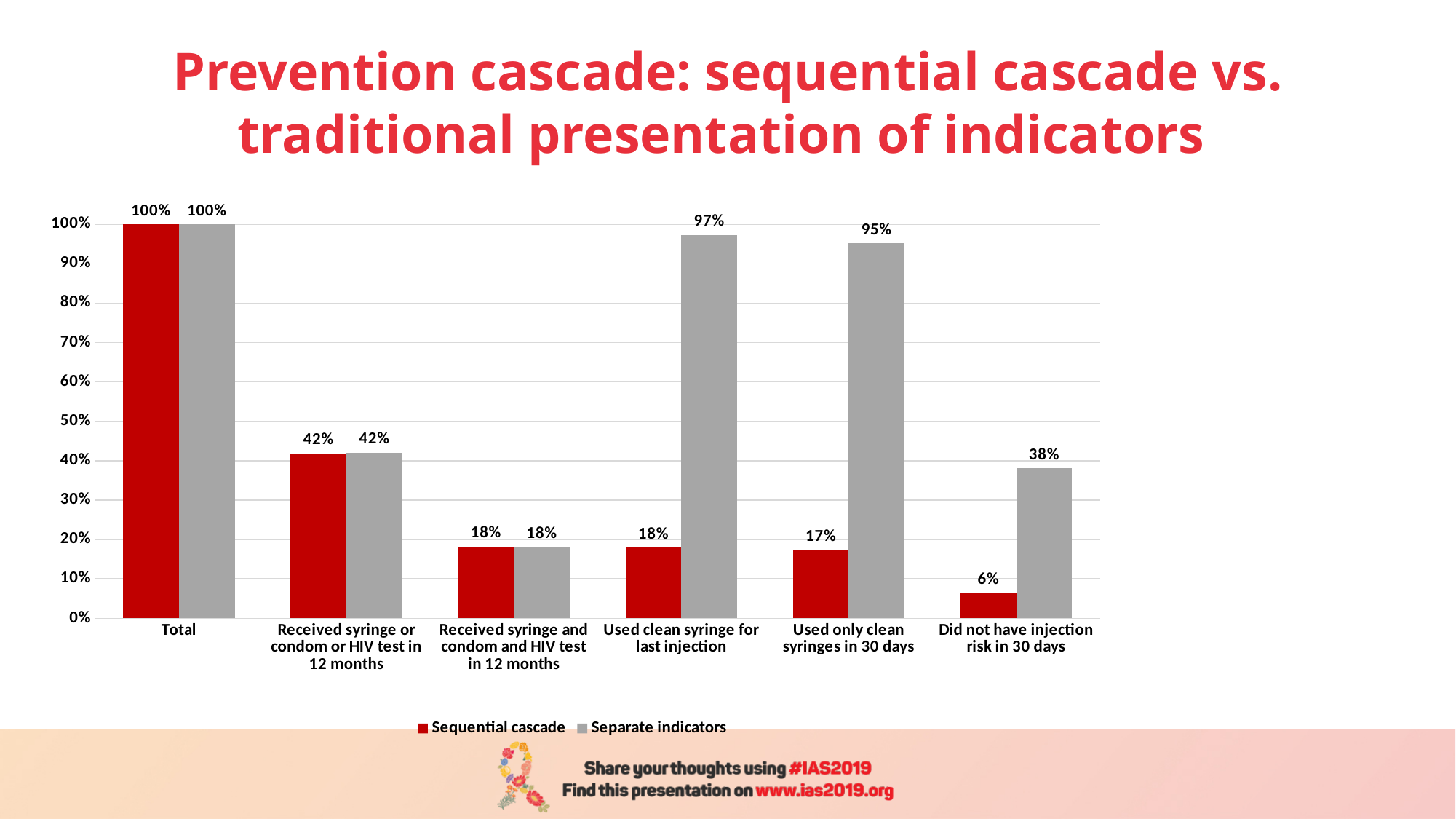
What is the difference between the Separate indicators and Sequential cascade values for 'Used only clean syringes in 30 days'? 78% Do the Sequential cascade values rise or fall from left to right along the x axis? Fall What kind of chart is shown on the slide? Bar chart For 'Did not have injection risk in 30 days', which series has the larger value: Sequential cascade or Separate indicators? Separate indicators How many categories are shown on the x axis? 6 What is the Separate indicators value for 'Used clean syringe for last injection'? 97% What is the Separate indicators value for 'Did not have injection risk in 30 days'? 38% Which category has the lowest Sequential cascade value? Did not have injection risk in 30 days What is the Sequential cascade value for 'Used only clean syringes in 30 days'? 17% What is the Sequential cascade value for 'Received syringe or condom or HIV test in 12 months'? 42% Which category has the lowest Separate indicators value? Received syringe and condom and HIV test in 12 months How many series does the legend list? 2